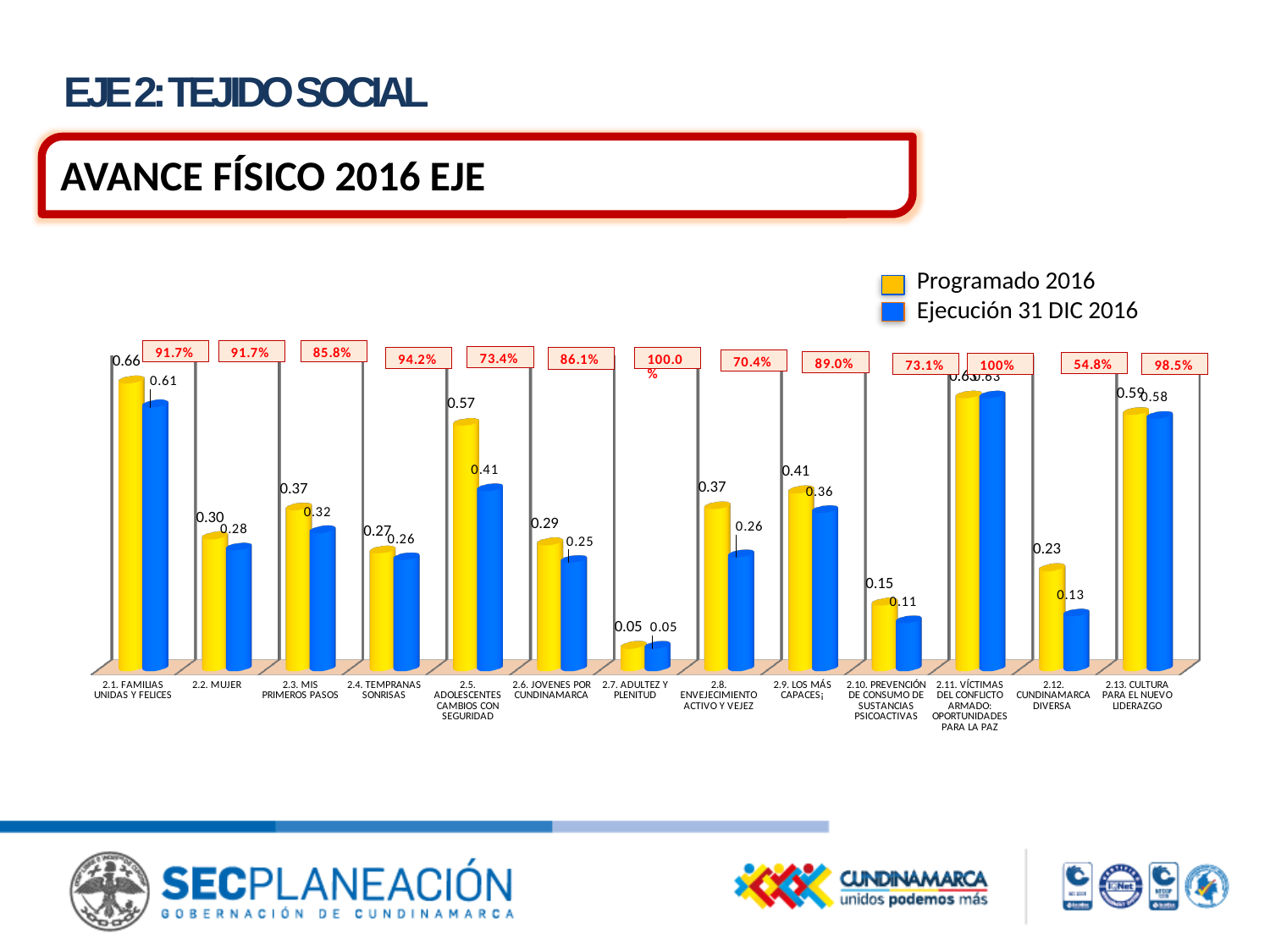
What is the Ejecución 31 DIC 2016 value for 2.12. CUNDINAMARCA DIVERSA? 0.13 How many series does the legend list? 2 Which colour represents the Ejecución 31 DIC 2016 series in the legend? Blue What percentage is shown in the box above 2.12. CUNDINAMARCA DIVERSA? 54.8% Which category has the highest Programado 2016 value? 2.1. FAMILIAS UNIDAS Y FELICES What is the Ejecución 31 DIC 2016 value for 2.5. ADOLESCENTES CAMBIOS CON SEGURIDAD? 0.41 What is the Programado 2016 value for 2.1. FAMILIAS UNIDAS Y FELICES? 0.66 Which is larger for 2.9. LOS MÁS CAPACES: the Programado 2016 value or the Ejecución 31 DIC 2016 value? Programado 2016 What kind of chart is shown on the slide? Bar chart How many categories (programs) are shown on the x axis of the chart? 13 Which category has the lowest Programado 2016 value? 2.7. ADULTEZ Y PLENITUD What is the difference between the Programado 2016 and Ejecución 31 DIC 2016 values for 2.8. ENVEJECIMIENTO ACTIVO Y VEJEZ? 0.11